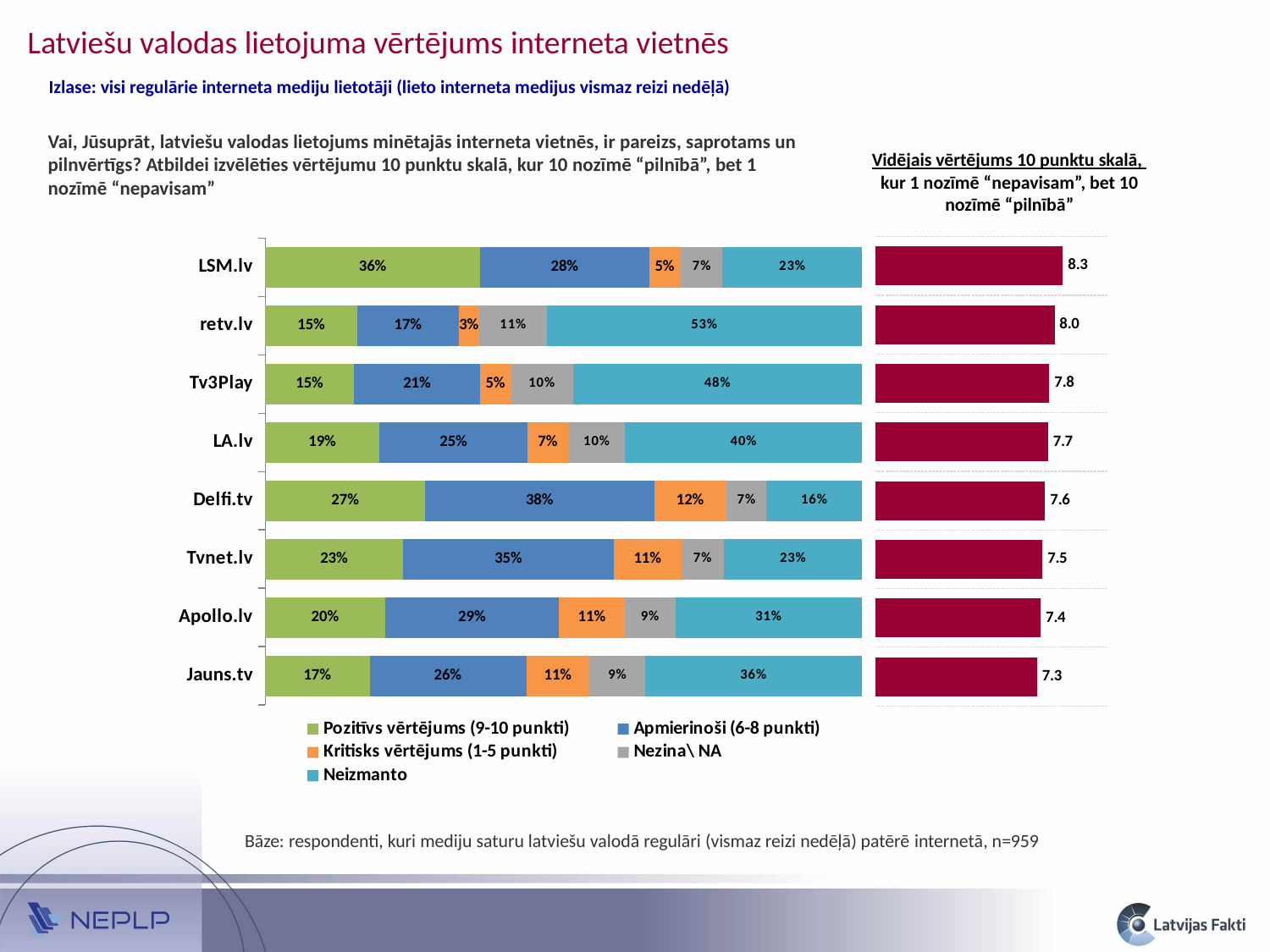
In the stacked bar chart on the left, what is the "Neizmanto" value for retv.lv? 53% In the chart on the right titled "Vidējais vērtējums 10 punktu skalā", what is the difference between the average rating of LSM.lv and Jauns.tv? 1.0 What type of chart is the chart on the left? Stacked bar chart In the chart on the right titled "Vidējais vērtējums 10 punktu skalā", what is the average rating for Tv3Play? 7.8 In the stacked bar chart on the left, which site has the highest "Neizmanto" share? retv.lv How many series does the legend of the stacked bar chart on the left list? 5 In the stacked bar chart on the left, which has a larger "Apmierinoši (6-8 punkti)" share, Delfi.tv or Tvnet.lv? Delfi.tv In the chart on the right titled "Vidējais vērtējums 10 punktu skalā", which site has the lowest average rating? Jauns.tv In the stacked bar chart on the left, what is the "Nezina\ NA" value for Apollo.lv? 9% In the chart on the right titled "Vidējais vērtējums 10 punktu skalā", which site has the highest average rating? LSM.lv How many websites are listed in the stacked bar chart on the left? 8 In the stacked bar chart on the left, what is the value of "Pozitīvs vērtējums (9-10 punkti)" for LSM.lv? 36%